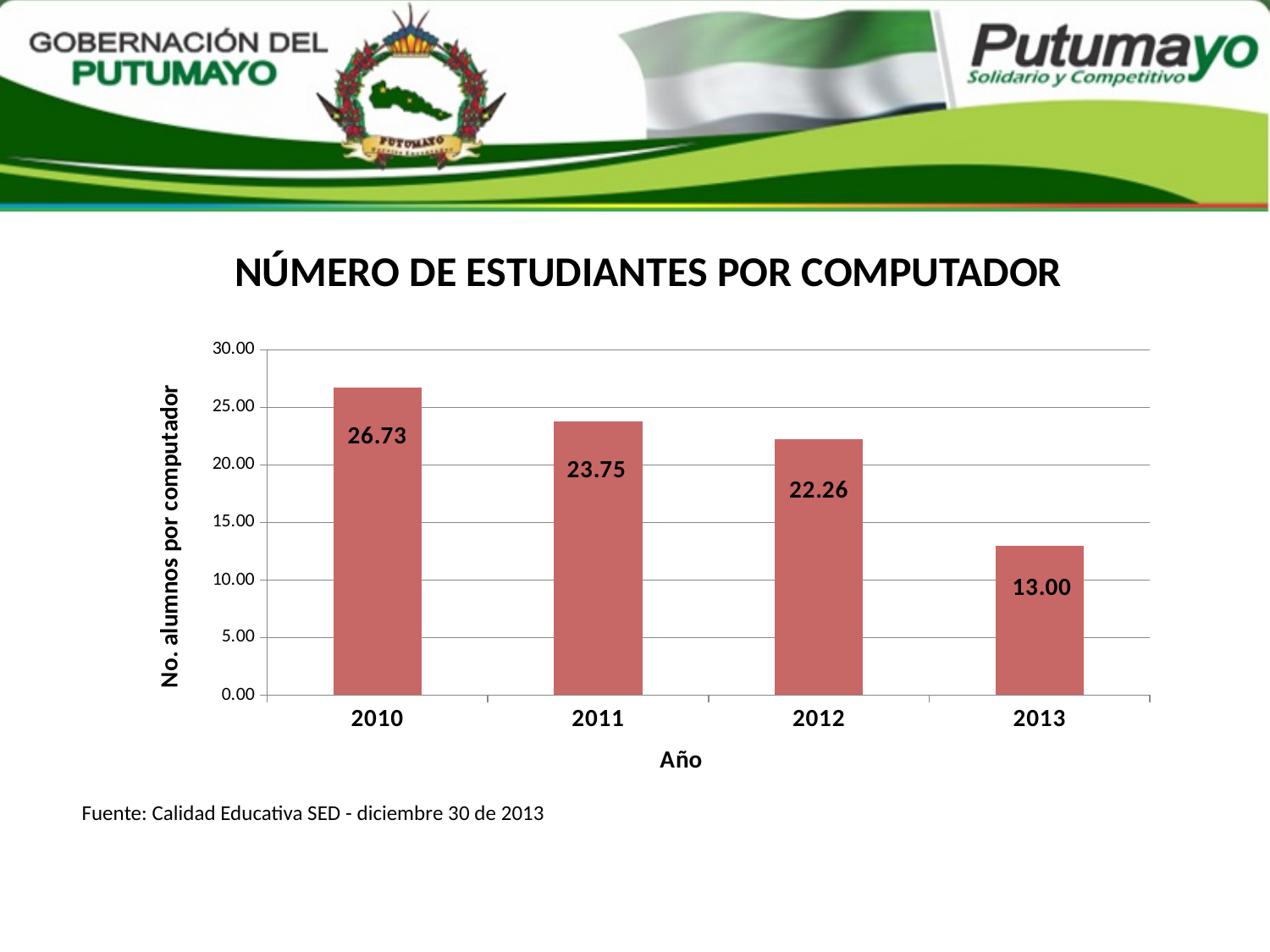
Which year has the lowest number of students per computer? 2013 What is the number of students per computer in 2013? 13.00 How many years are shown on the x axis? 4 What is the difference between the values for 2011 and 2012? 1.49 Which year has the highest number of students per computer? 2010 Do the values rise or fall from 2010 to 2013? fall Is the value for 2012 greater or less than 20.00? greater Which year has a larger value, 2011 or 2012? 2011 What kind of chart is shown on the slide? bar chart What is the difference between the values for 2010 and 2013? 13.73 What is the value shown for 2011? 23.75 What is the number of students per computer in 2010? 26.73